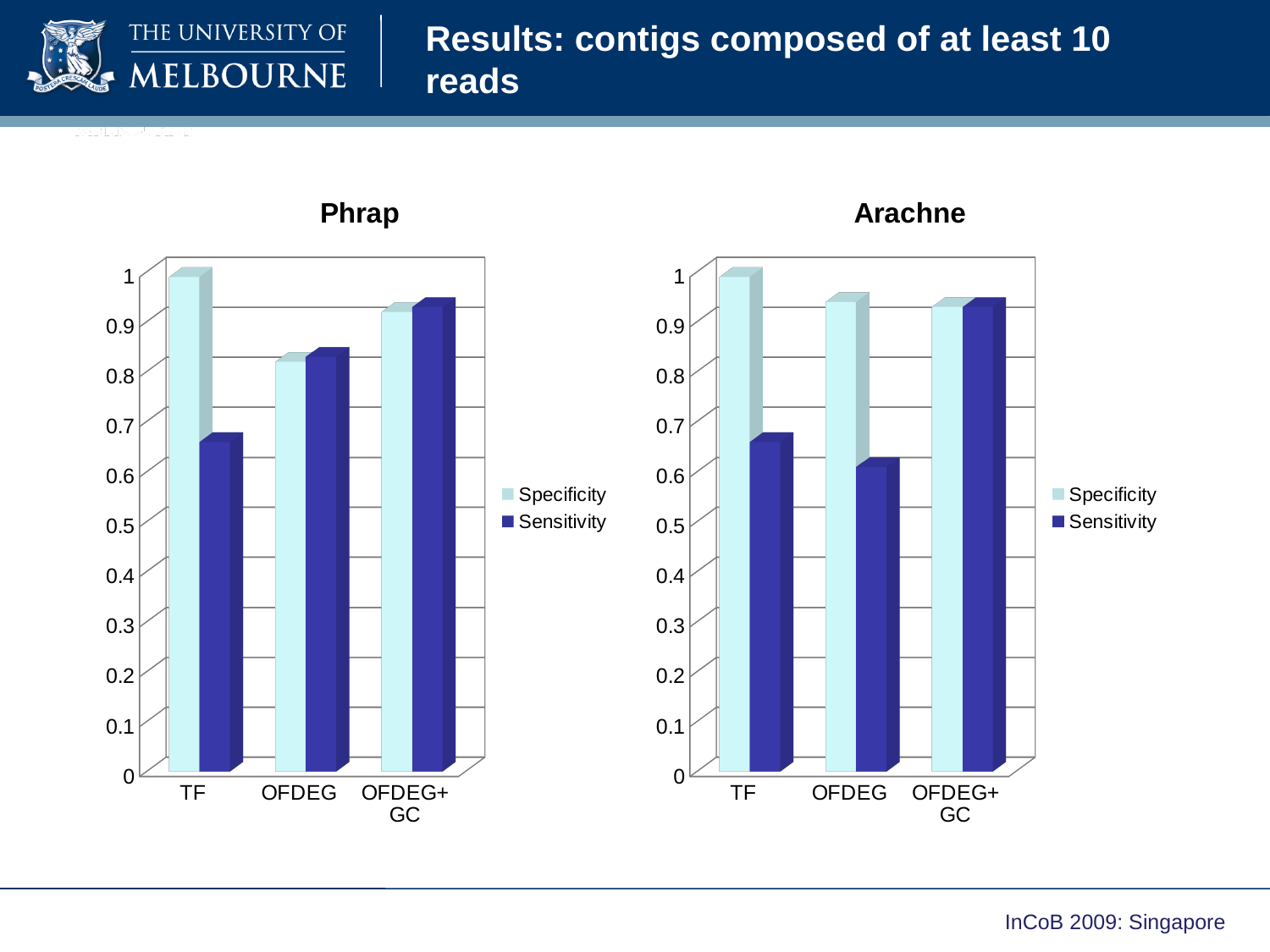
In the Arachne chart, is the Specificity value for TF greater or less than 0.9? greater In the Arachne chart, is the Sensitivity value for OFDEG greater or less than 0.7? less In the Phrap chart, which category has the lowest Sensitivity? TF What are the titles of the two charts on the slide? Phrap and Arachne In the Phrap chart, is the Sensitivity value for TF greater or less than 0.7? less How many categories are shown on the x axis of the Arachne chart? 3 In the Arachne chart, which is larger for OFDEG: Specificity or Sensitivity? Specificity In the Arachne chart, which category has the lowest Sensitivity? OFDEG In the Phrap chart, which category has the highest Specificity? TF What kind of chart is the Phrap chart? bar chart How many series does the legend of the Phrap chart list? 2